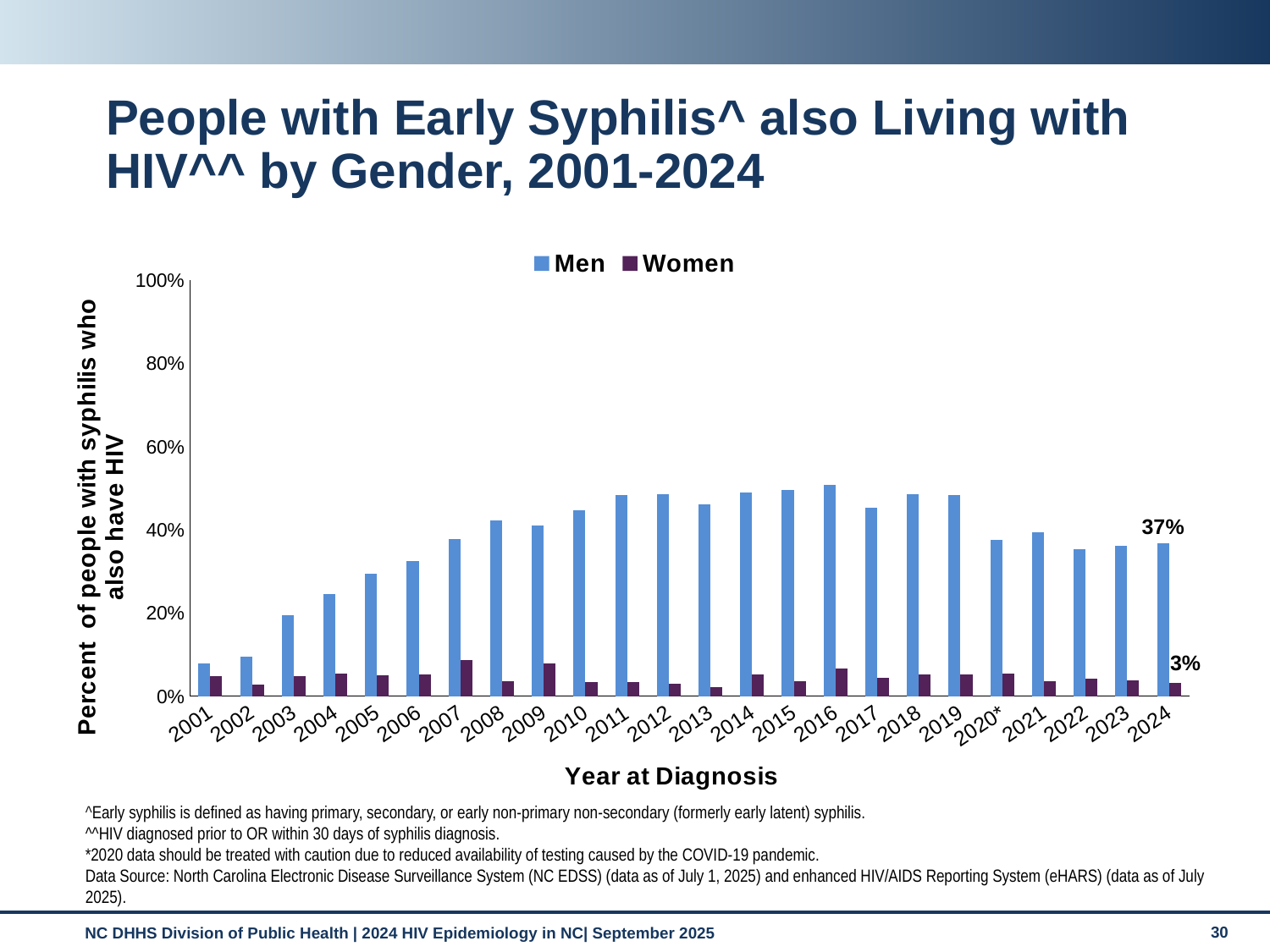
What is the difference between the Men and Women values in 2024? 34 percentage points What kind of chart is shown on the slide? Bar chart What is the title of the x axis? Year at Diagnosis Is the value for Men in 2011 greater or less than 40%? greater Is the value for Men in 2001 greater or less than 20%? less Which year has the lowest value for Men? 2001 What is the value for Women in 2024? 3% Do the values for Men rise or fall from 2001 to 2011? Rise How many series does the legend list? 2 What is the value for Men in 2024? 37% How many years are shown on the x axis? 24 In 2024, which is larger, the value for Men or the value for Women? Men